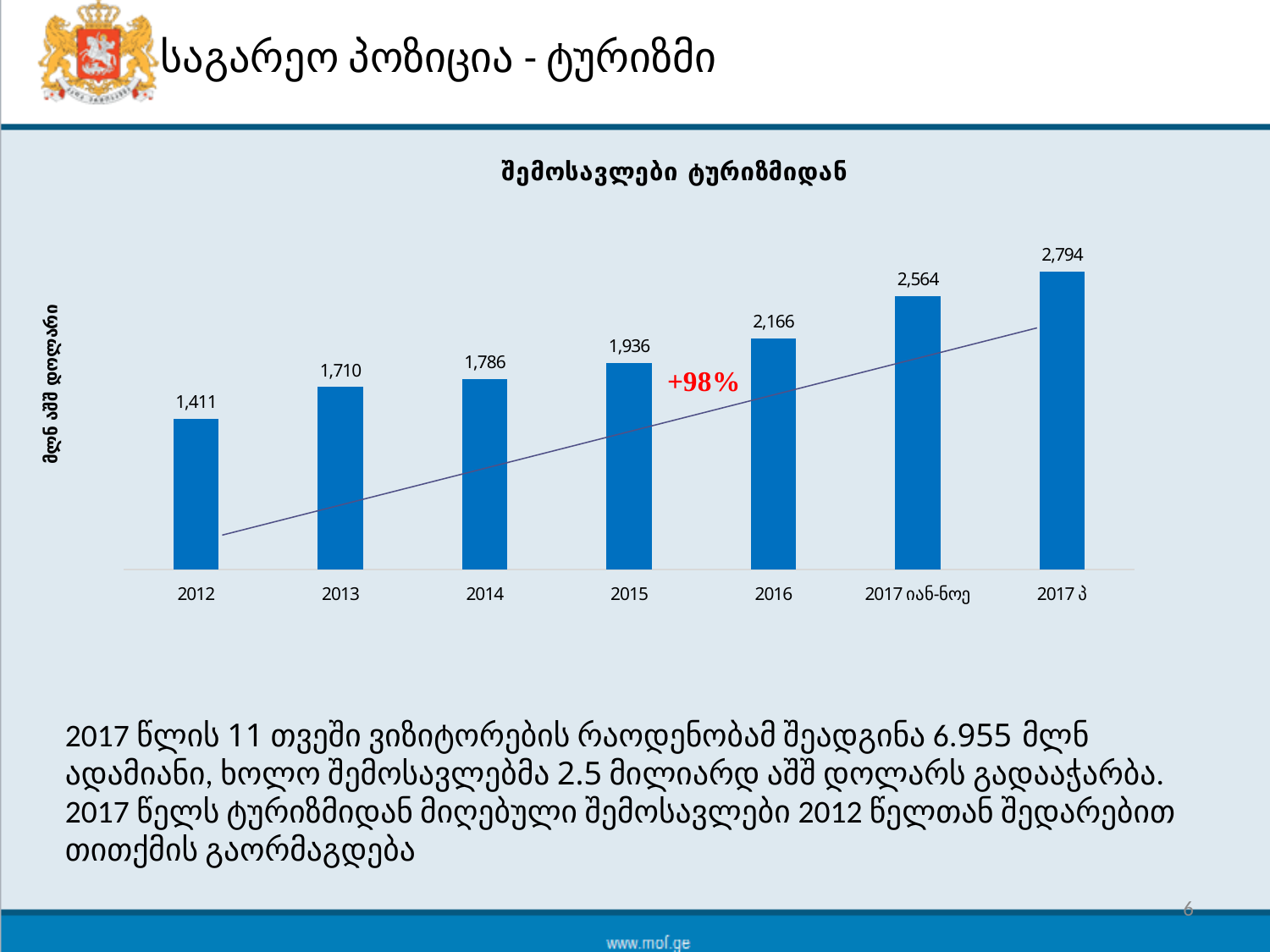
What is the value for 2016? 2,166 What is the difference between the values for 2017 პ and 2012? 1,383 How many bars are shown in the chart? 7 Which category has the lowest value? 2012 What is the value for 2017 პ? 2,794 Do the values rise or fall from 2012 to 2017 პ? Rise What is the difference between the values for 2014 and 2013? 76 What is the value for 2012? 1,411 What is the value for 2017 იან-ნოე? 2,564 What type of chart is shown on the slide? Bar chart Which category has the highest value? 2017 პ Which is larger, the value for 2015 or the value for 2016? 2016